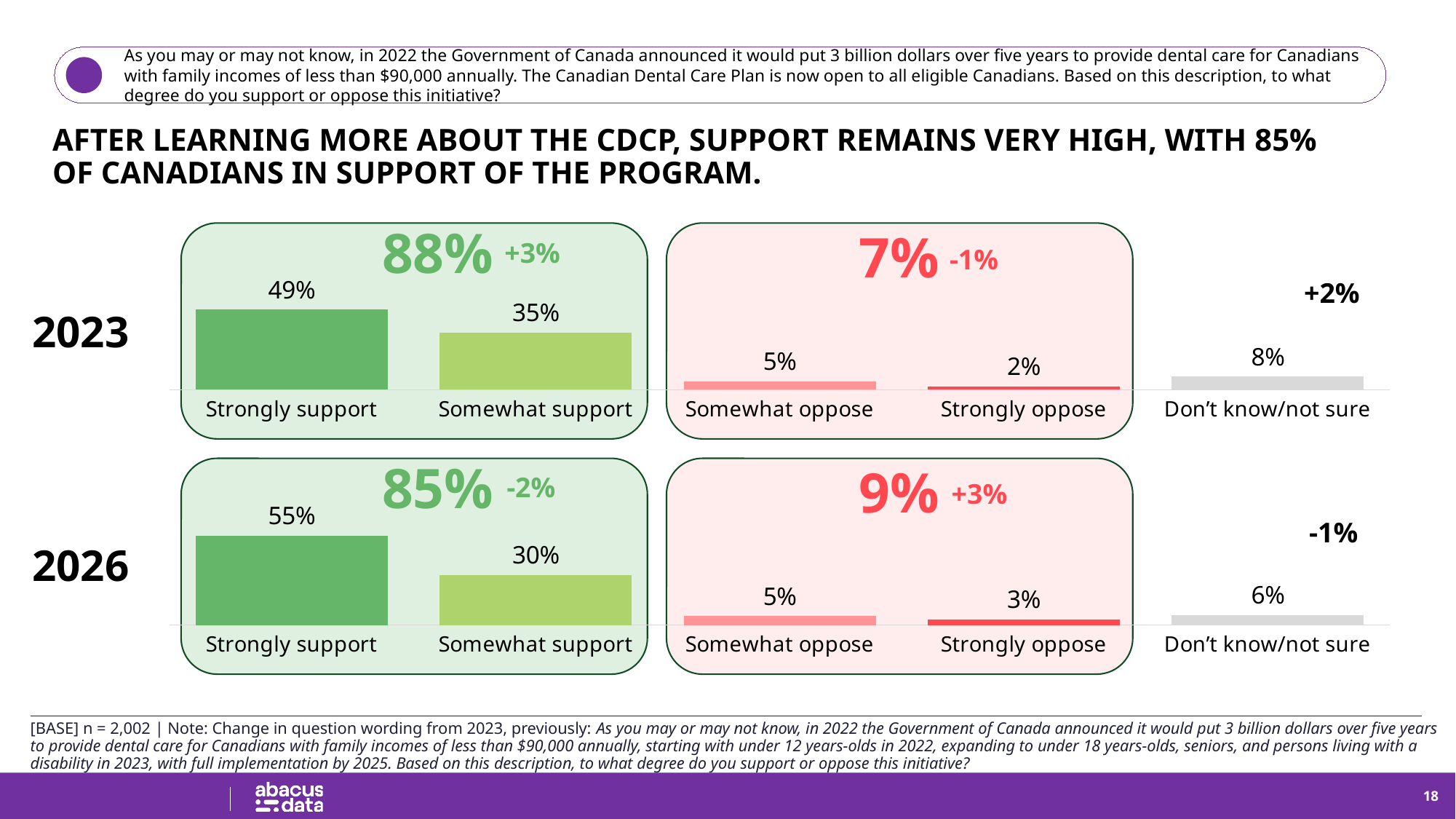
In the 2026 chart, what change from 2023 is shown next to the 9% oppose total? +3% In the 2023 chart, what is the combined total shown for Strongly support and Somewhat support? 88% In the 2026 chart, what is the difference between Strongly support and Somewhat support? 25% In the 2026 chart, what is the value for Somewhat support? 30% In the 2023 chart, which category has the lowest value? Strongly oppose In the 2023 chart, which is larger: Somewhat oppose or Don't know/not sure? Don't know/not sure In the 2023 chart, what is the value for Strongly support? 49% In the 2023 chart, what is the value for Don't know/not sure? 8% In the 2026 chart, what is the value for Strongly oppose? 3% What kind of chart is used for the 2023 results? Bar chart In the 2026 chart, which category has the highest value? Strongly support How many categories are shown in the 2026 chart? 5